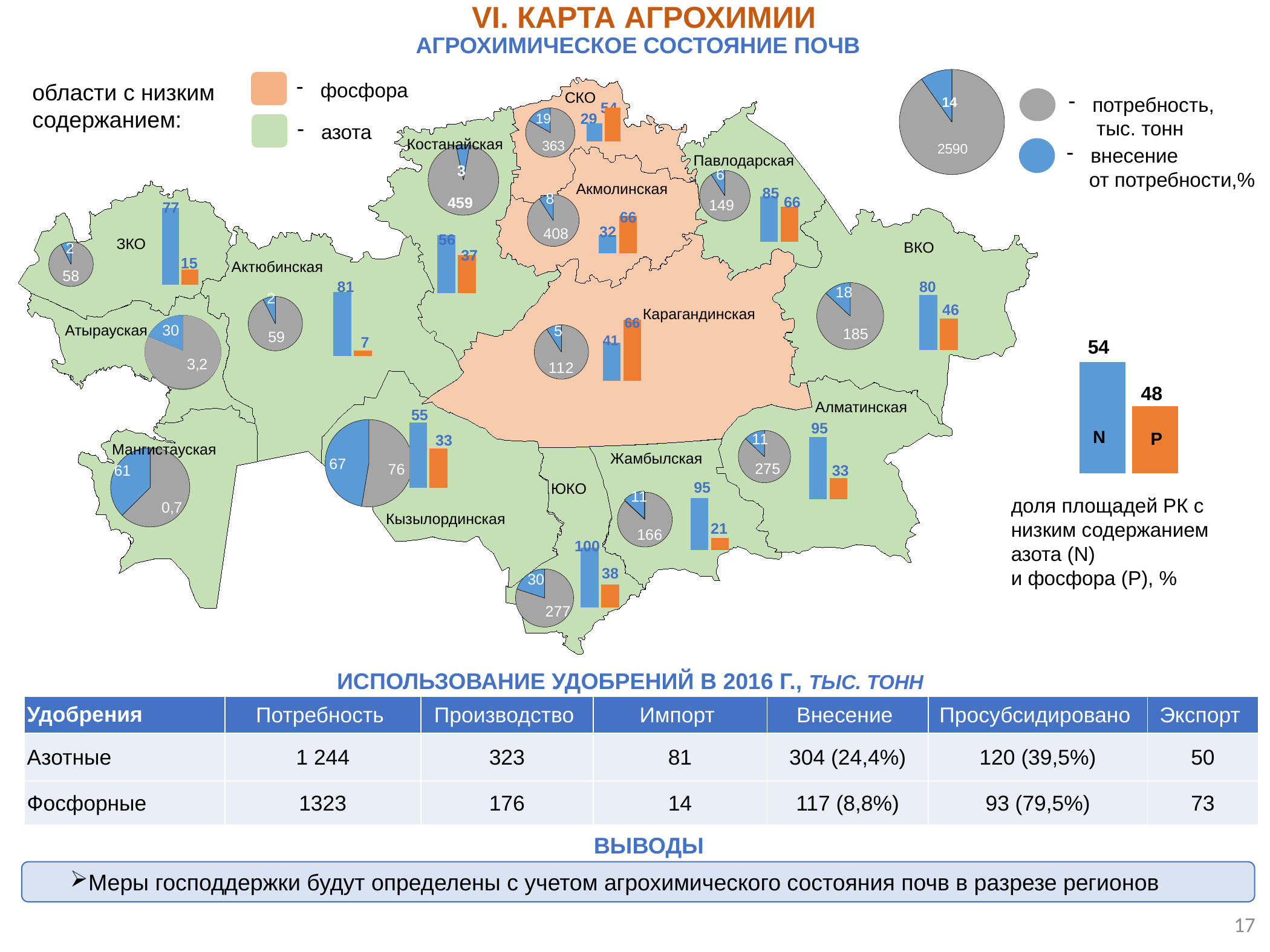
On the map, what is the value printed in the blue part of the pie chart for the Мангистауская region? 61 On the map, what is the orange bar value for the Актюбинская region? 7 On the bar chart at the right of the map showing the share of areas with low N and P, what is the difference between the N and P values? 6 On the bar chart at the right of the map showing the share of areas with low nitrogen (N) and phosphorus (P), what is the value for P? 48 On the map, what is the blue bar value for the ЮКО region? 100 How many bars does the N/P chart at the right of the map have? 2 On the bar chart at the right of the map showing the share of areas with low nitrogen (N) and phosphorus (P), what is the value for N? 54 On the map, which is larger for the Карагандинская region, the blue bar or the orange bar? orange bar On the map, what is the value printed in the grey part of the pie chart for the Костанайская region? 459 On the bar chart at the right of the map showing the share of areas with low N and P, which bar is higher, N or P? N What kind of chart is the N/P chart at the right of the map? bar chart On the map, what is the blue bar value for the Павлодарская region? 85